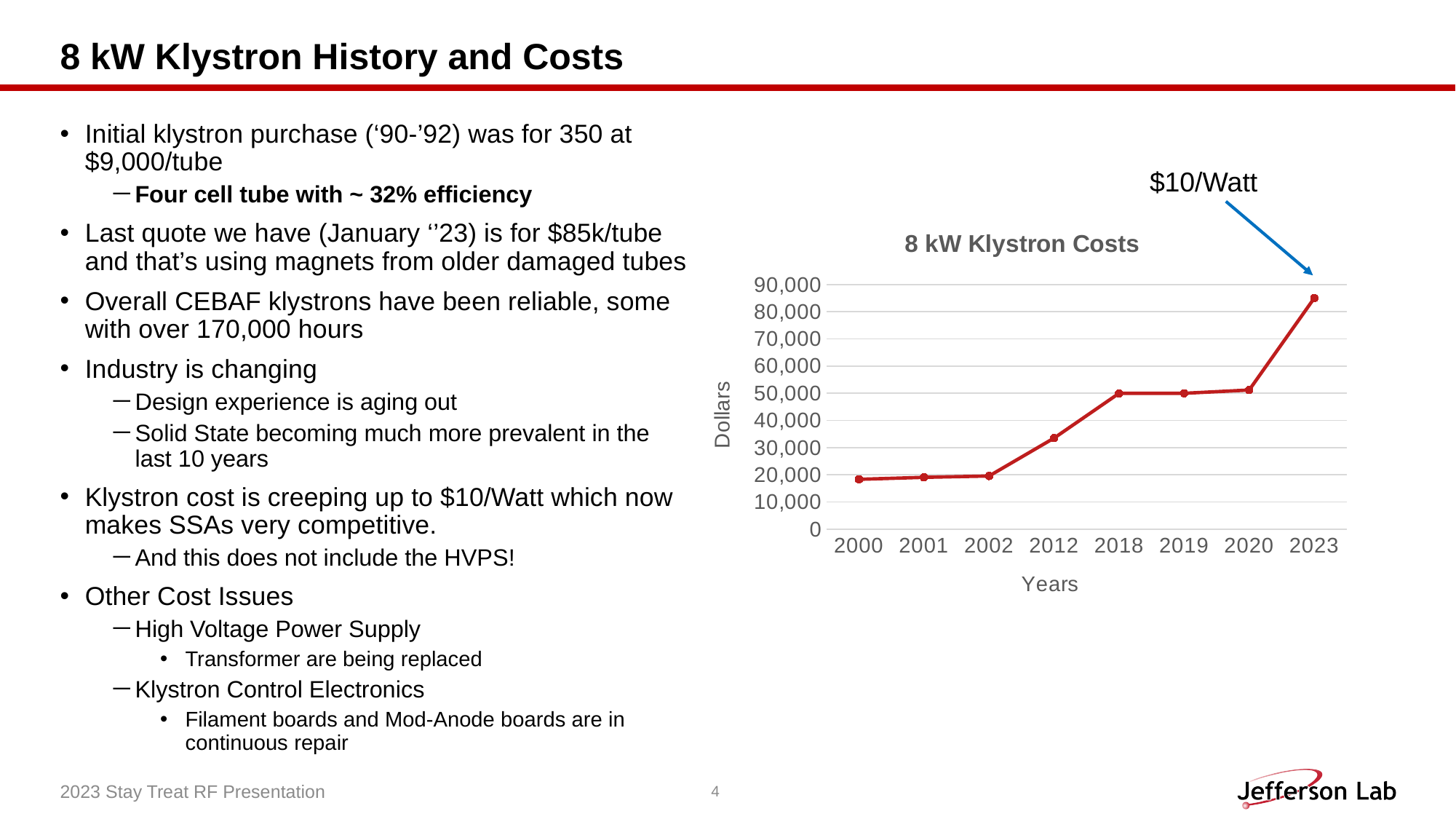
Is the value for 2012 greater or less than 40,000? less What is the title of the chart? 8 kW Klystron Costs Is the value for 2023 greater or less than 80,000? greater Which is larger, the value for 2020 or the value for 2023? 2023 Do the klystron costs generally rise or fall from 2000 to 2023? rise Is the value for 2000 greater or less than 20,000? less Which is larger, the value for 2012 or the value for 2018? 2018 How many years are plotted on the x axis of the chart? 8 What is the label on the vertical axis of the chart? Dollars What kind of chart is shown on the slide? line chart Which year has the highest klystron cost in the chart? 2023